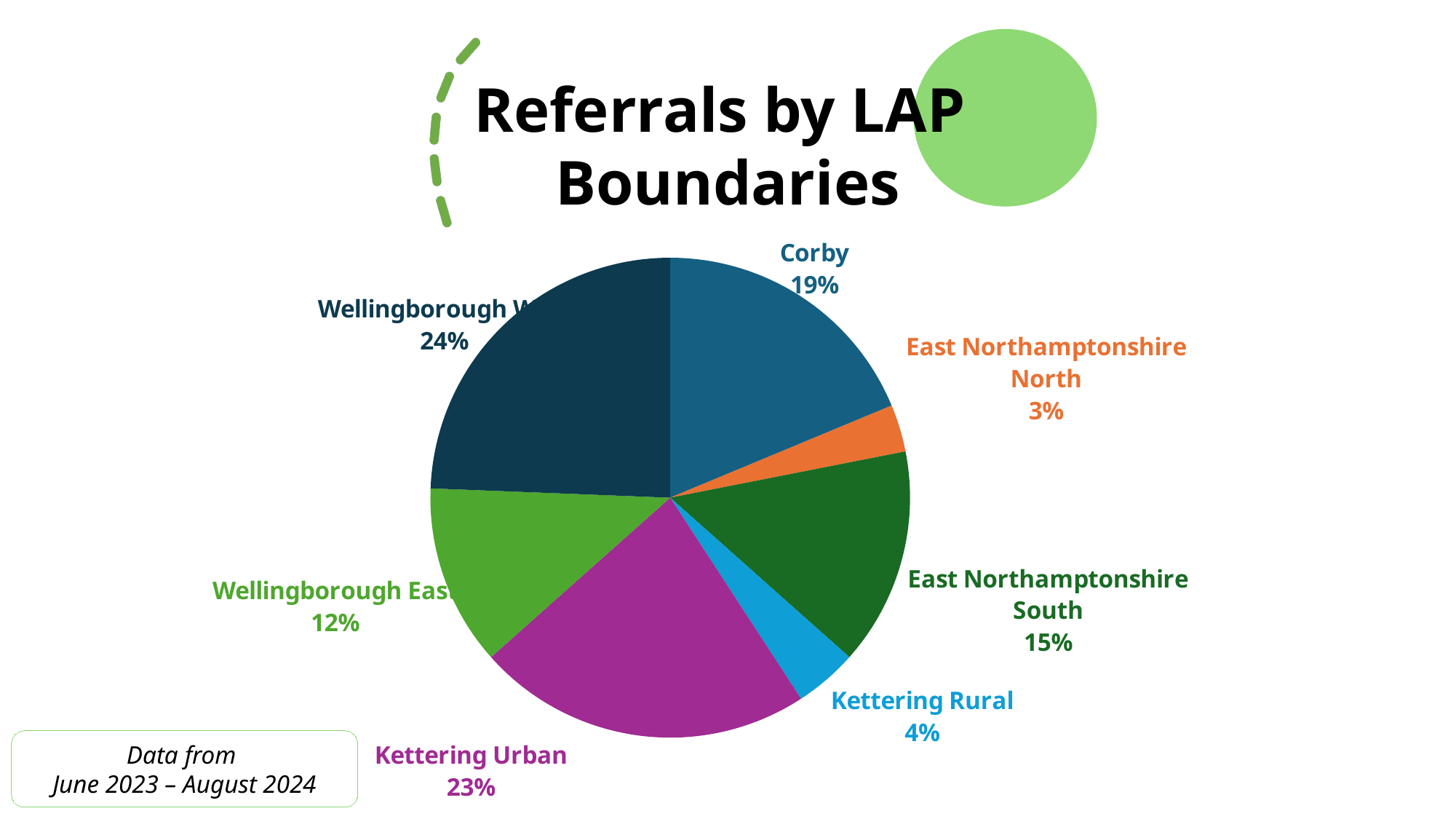
What percentage of referrals does the Corby slice represent? 19% What percentage is shown for East Northamptonshire South? 15% Which has a larger share of referrals, Corby or East Northamptonshire South? Corby What share of referrals is attributed to Kettering Urban? 23% What kind of chart is shown on the slide? Pie chart What is the combined share of Kettering Urban and Kettering Rural? 27% What is the difference in percentage points between Kettering Urban and Corby? 4 percentage points What is the title of the chart? Referrals by LAP Boundaries What percentage is shown for Wellingborough East? 12% How many slices does the pie chart have? 7 Which LAP boundary has the smallest share of referrals? East Northamptonshire North Which has a larger share of referrals, Kettering Rural or East Northamptonshire North? Kettering Rural